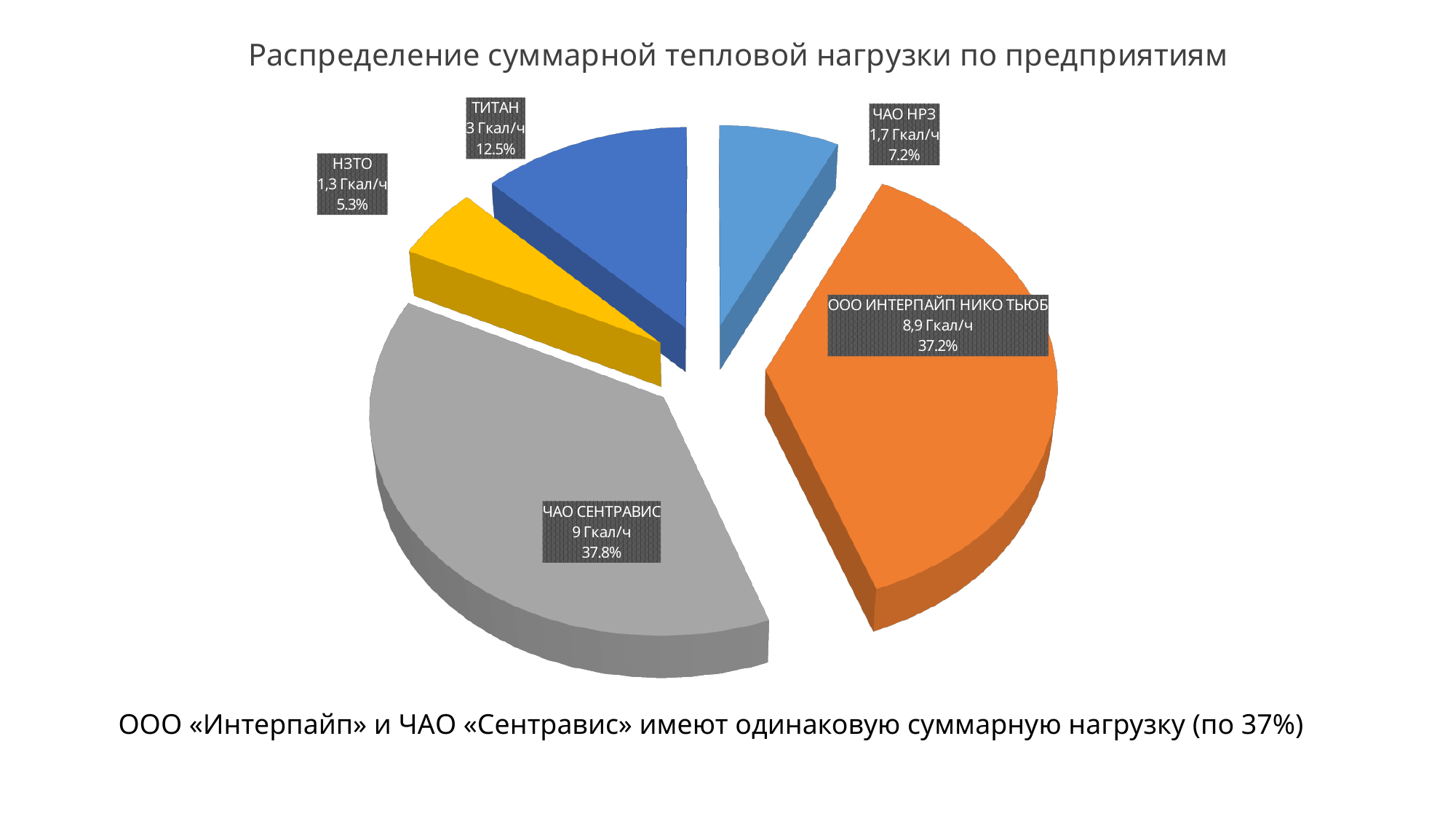
Which enterprise has the largest share of the total heat load? ЧАО СЕНТРАВИС What kind of chart is shown on the slide? pie chart What is the difference in heat load between ТИТАН and НЗТО? 1,7 Гкал/ч What is the heat load value for ООО ИНТЕРПАЙП НИКО ТЬЮБ? 8,9 Гкал/ч How many slices does the pie chart have? 5 What share of the pie does НЗТО account for? 5.3% Which enterprise has the smallest share of the total heat load? НЗТО What is the heat load value for ТИТАН? 3 Гкал/ч What share of the pie does ТИТАН account for? 12.5% What is the title of the chart? Распределение суммарной тепловой нагрузки по предприятиям What is the heat load value for ЧАО НРЗ? 1,7 Гкал/ч Which has a larger heat load, ЧАО НРЗ or НЗТО? ЧАО НРЗ